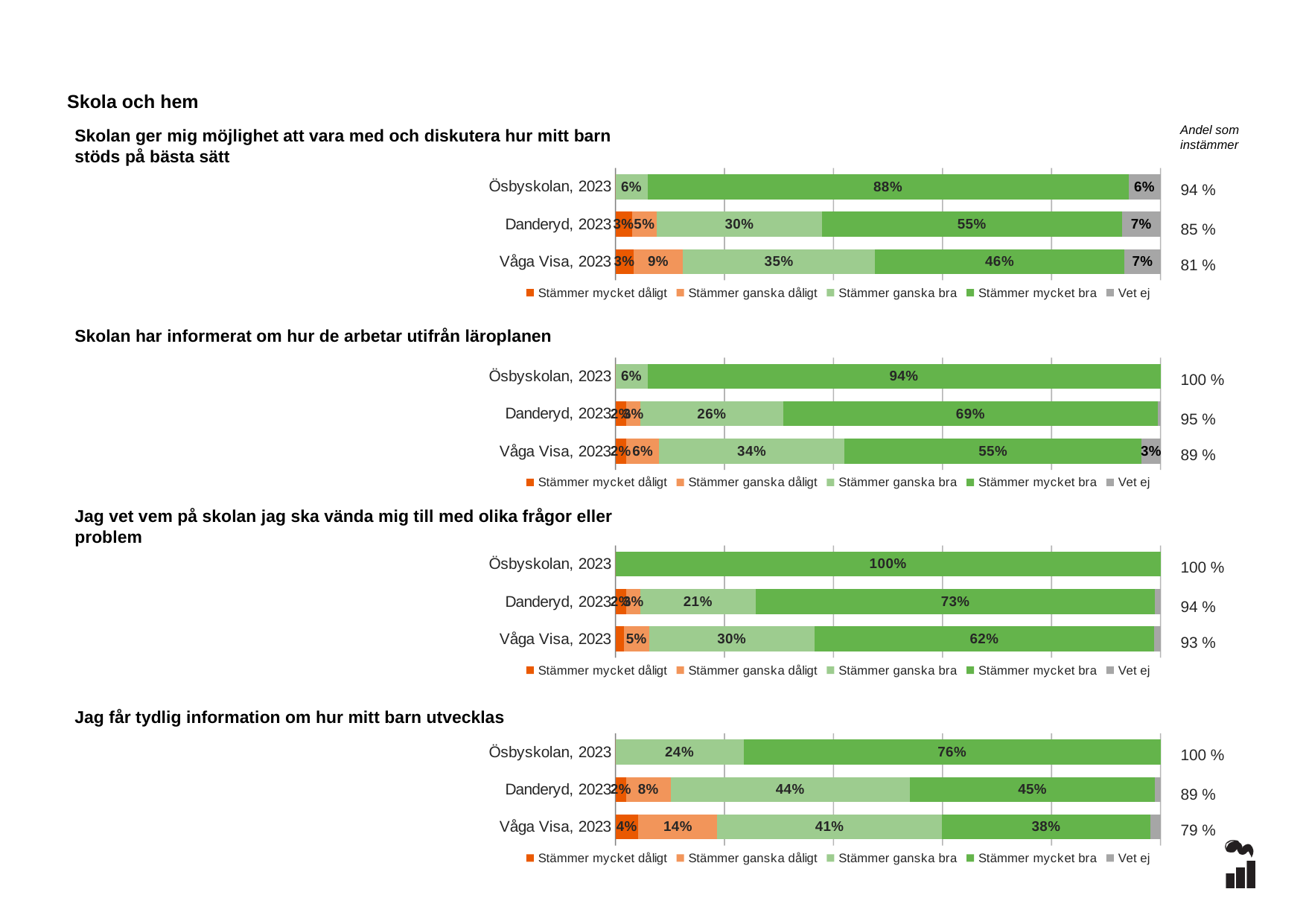
In the chart "Skolan har informerat om hur de arbetar utifrån läroplanen", which row has the highest "Stämmer mycket bra" value? Ösbyskolan, 2023 In the chart "Jag får tydlig information om hur mitt barn utvecklas", which row has the lowest "Stämmer mycket bra" value? Våga Visa, 2023 In the chart "Skolan ger mig möjlighet att vara med och diskutera hur mitt barn stöds på bästa sätt", what is the "Stämmer ganska bra" value for Våga Visa, 2023? 35% What kind of chart is "Jag får tydlig information om hur mitt barn utvecklas"? Stacked bar chart In the chart "Jag får tydlig information om hur mitt barn utvecklas", what is the "Stämmer ganska dåligt" value for Våga Visa, 2023? 14% In the chart "Jag vet vem på skolan jag ska vända mig till med olika frågor eller problem", what is the difference between the "Stämmer mycket bra" values for Danderyd, 2023 and Våga Visa, 2023? 11% In the chart "Skolan ger mig möjlighet att vara med och diskutera hur mitt barn stöds på bästa sätt", what is the "Stämmer mycket bra" value for Ösbyskolan, 2023? 88% In the chart "Jag får tydlig information om hur mitt barn utvecklas", which is larger: the "Stämmer ganska bra" value for Danderyd, 2023 or for Våga Visa, 2023? Danderyd, 2023 How many rows (categories) are shown in the chart "Skolan ger mig möjlighet att vara med och diskutera hur mitt barn stöds på bästa sätt"? 3 How many series does the legend list in the chart "Skolan har informerat om hur de arbetar utifrån läroplanen"? 5 In the chart "Skolan har informerat om hur de arbetar utifrån läroplanen", what is the "Stämmer mycket bra" value for Danderyd, 2023? 69% In the chart "Jag vet vem på skolan jag ska vända mig till med olika frågor eller problem", what is the "Stämmer mycket bra" value for Ösbyskolan, 2023? 100%